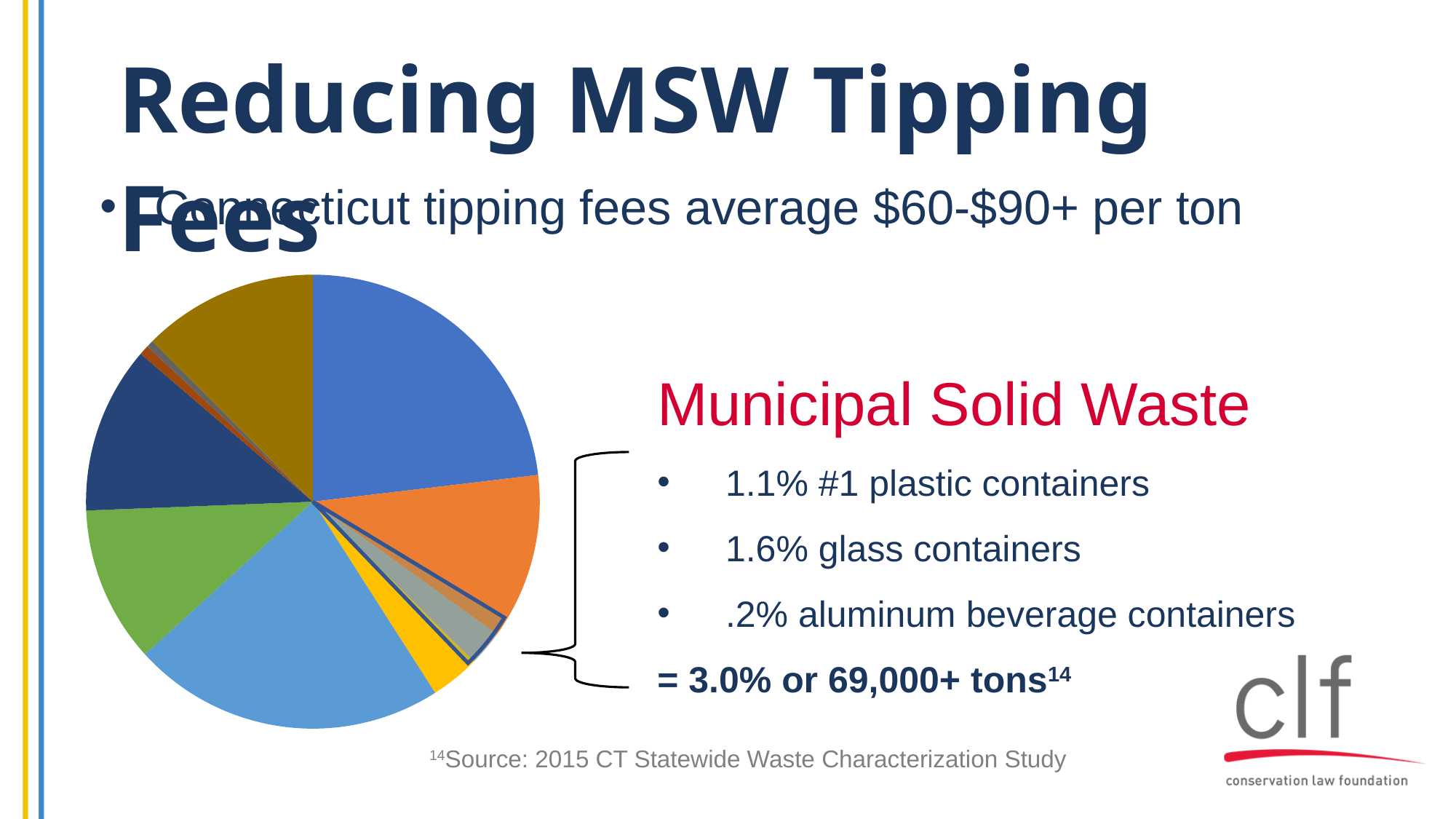
What share of municipal solid waste is aluminum beverage containers? .2% Which has a larger share, glass containers or #1 plastic containers? glass containers What kind of chart is shown on the slide? pie chart What is the combined share of the three labelled container categories? 3.0% What is the difference in share between glass containers and #1 plastic containers? 0.5% What is the title of the pie chart? Municipal Solid Waste What share of municipal solid waste is glass containers? 1.6% Of the three labelled container categories, which has the largest share? glass containers Of the three labelled container categories, which has the smallest share? aluminum beverage containers What share of municipal solid waste is #1 plastic containers? 1.1% How many tons do the three labelled container categories represent? 69,000+ tons What colour is the largest slice of the pie chart? blue